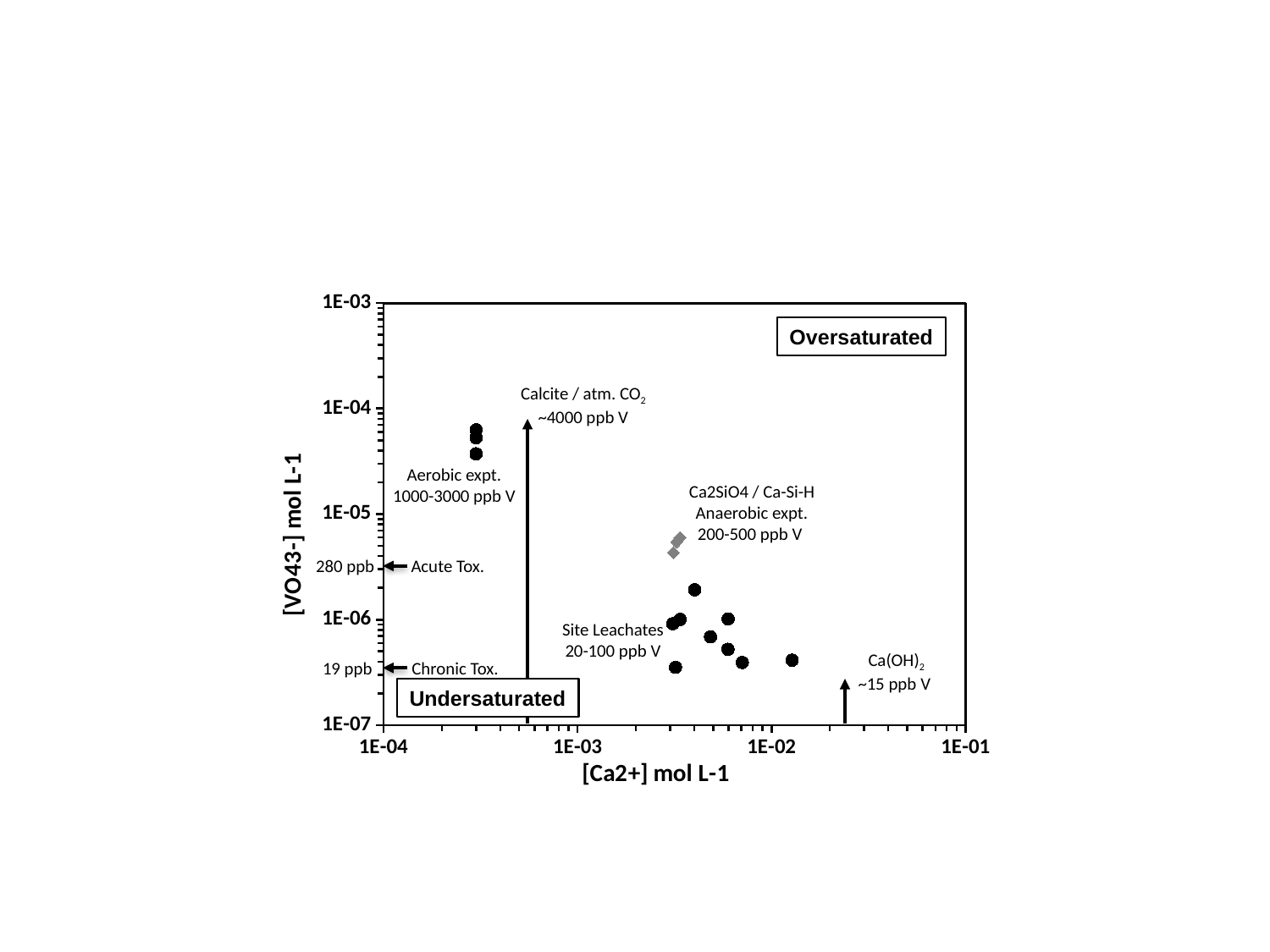
What kind of chart is shown on the slide? scatter plot Is the [Ca2+] value for the Aerobic expt. points greater or less than 1E-03? less What vanadium concentration is marked for the Acute Tox. line? 280 ppb What vanadium concentration is marked for the Chronic Tox. line? 19 ppb What approximate vanadium concentration is given for the Ca(OH)2 line? ~15 ppb V What vanadium concentration range is given for the Aerobic expt. points? 1000-3000 ppb V Is the [VO43-] value for the Aerobic expt. points greater or less than 1E-05? greater What is the label of the y axis? [VO43-] mol L-1 What approximate vanadium concentration is given for the Calcite / atm. CO2 line? ~4000 ppb V What is the label of the x axis? [Ca2+] mol L-1 What vanadium concentration range is given for the Site Leachates? 20-100 ppb V Which group has higher [VO43-] values, the Aerobic expt. points or the Site Leachates? Aerobic expt.